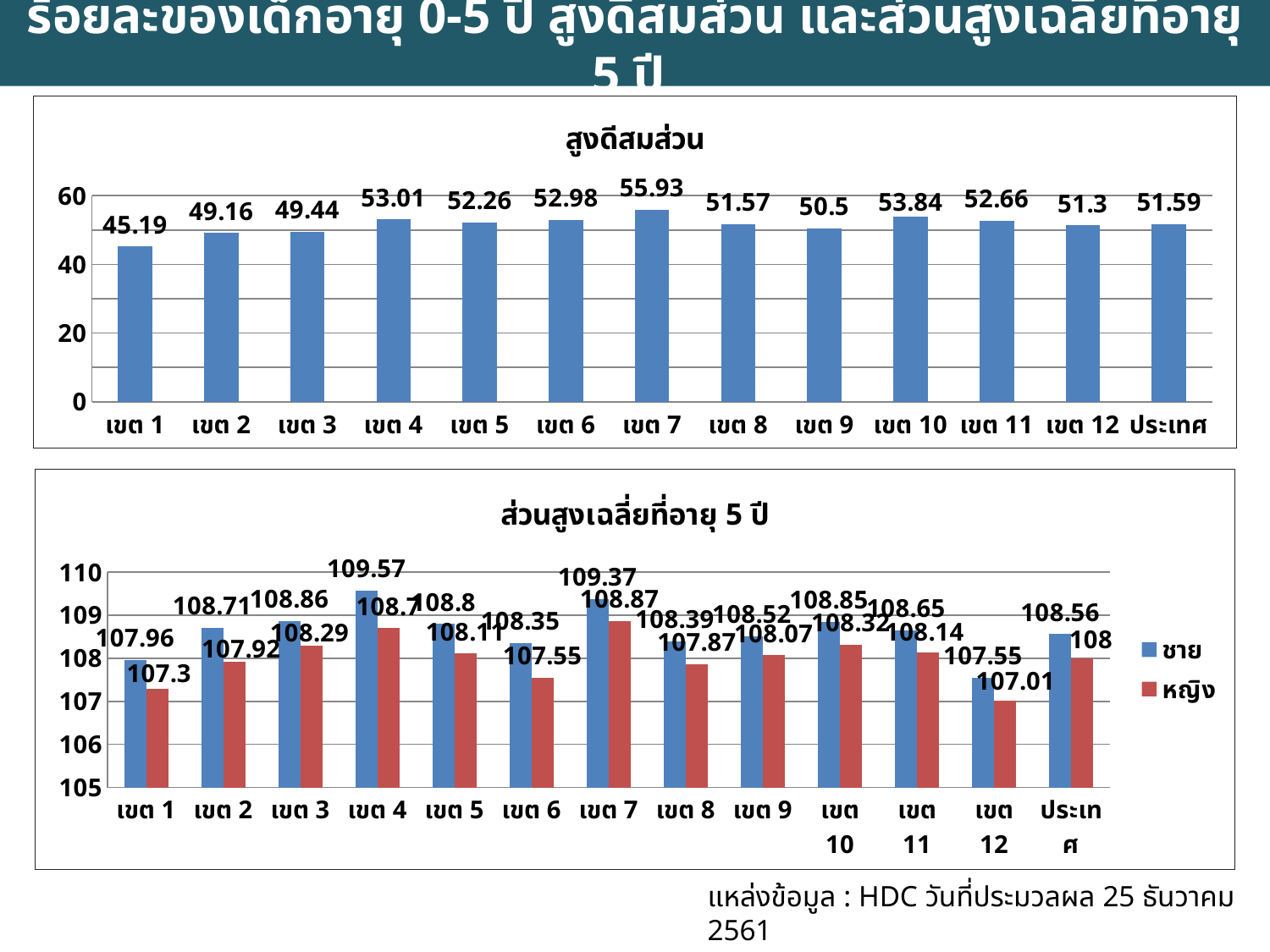
In the bottom chart titled ส่วนสูงเฉลี่ยที่อายุ 5 ปี, which is larger: ชาย in เขต 7 or ชาย in เขต 4? ชาย in เขต 4 In the top chart titled สูงดีสมส่วน, which category has the highest value? เขต 7 In the top chart titled สูงดีสมส่วน, how many categories are shown on the x axis? 13 In the bottom chart titled ส่วนสูงเฉลี่ยที่อายุ 5 ปี, how many series does the legend list? 2 In the top chart titled สูงดีสมส่วน, which category has the lowest value? เขต 1 In the bottom chart titled ส่วนสูงเฉลี่ยที่อายุ 5 ปี, what is the value for ชาย in เขต 4? 109.57 In the bottom chart titled ส่วนสูงเฉลี่ยที่อายุ 5 ปี, what is the value for หญิง in เขต 12? 107.01 In the top chart titled สูงดีสมส่วน, what is the difference between the values for เขต 7 and เขต 1? 10.74 In the bottom chart titled ส่วนสูงเฉลี่ยที่อายุ 5 ปี, what is the difference between ชาย and หญิง for ประเทศ? 0.56 In the top chart titled สูงดีสมส่วน, what is the value for เขต 7? 55.93 In the top chart titled สูงดีสมส่วน, what is the value for ประเทศ? 51.59 What kind of chart is the bottom chart titled ส่วนสูงเฉลี่ยที่อายุ 5 ปี? Bar chart